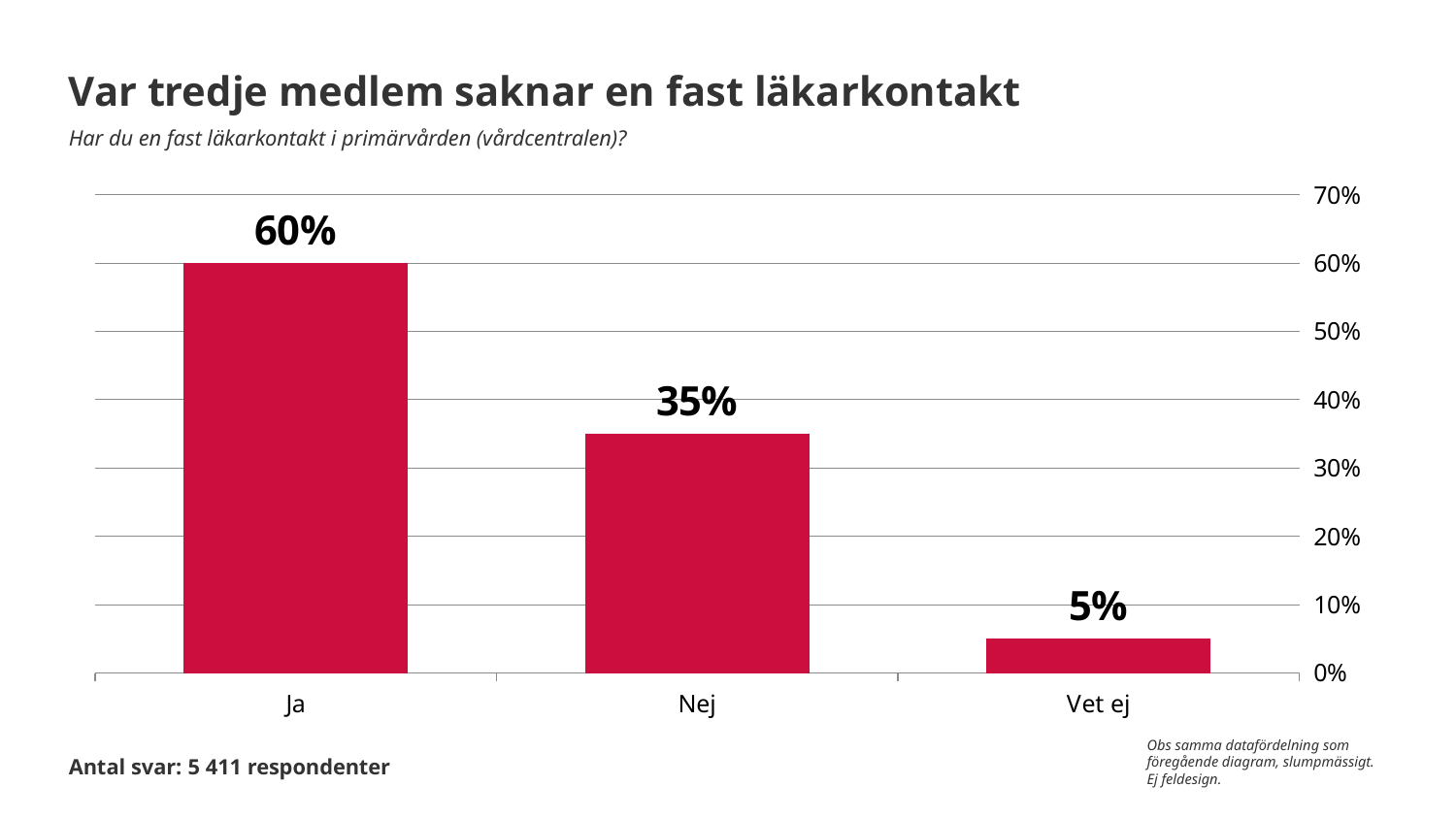
What is the value for "Nej"? 35% What is the difference between the values for "Nej" and "Vet ej"? 30% Is the value for "Nej" greater or less than 40%? less Which is larger, the value for "Nej" or the value for "Vet ej"? Nej What kind of chart is shown on the slide? bar chart How many categories are shown on the x axis? 3 What is the title of the slide above the chart? Var tredje medlem saknar en fast läkarkontakt What is the value for "Ja"? 60% Which category has the highest value? Ja What is the value for "Vet ej"? 5% Which category has the lowest value? Vet ej What is the difference between the values for "Ja" and "Nej"? 25%